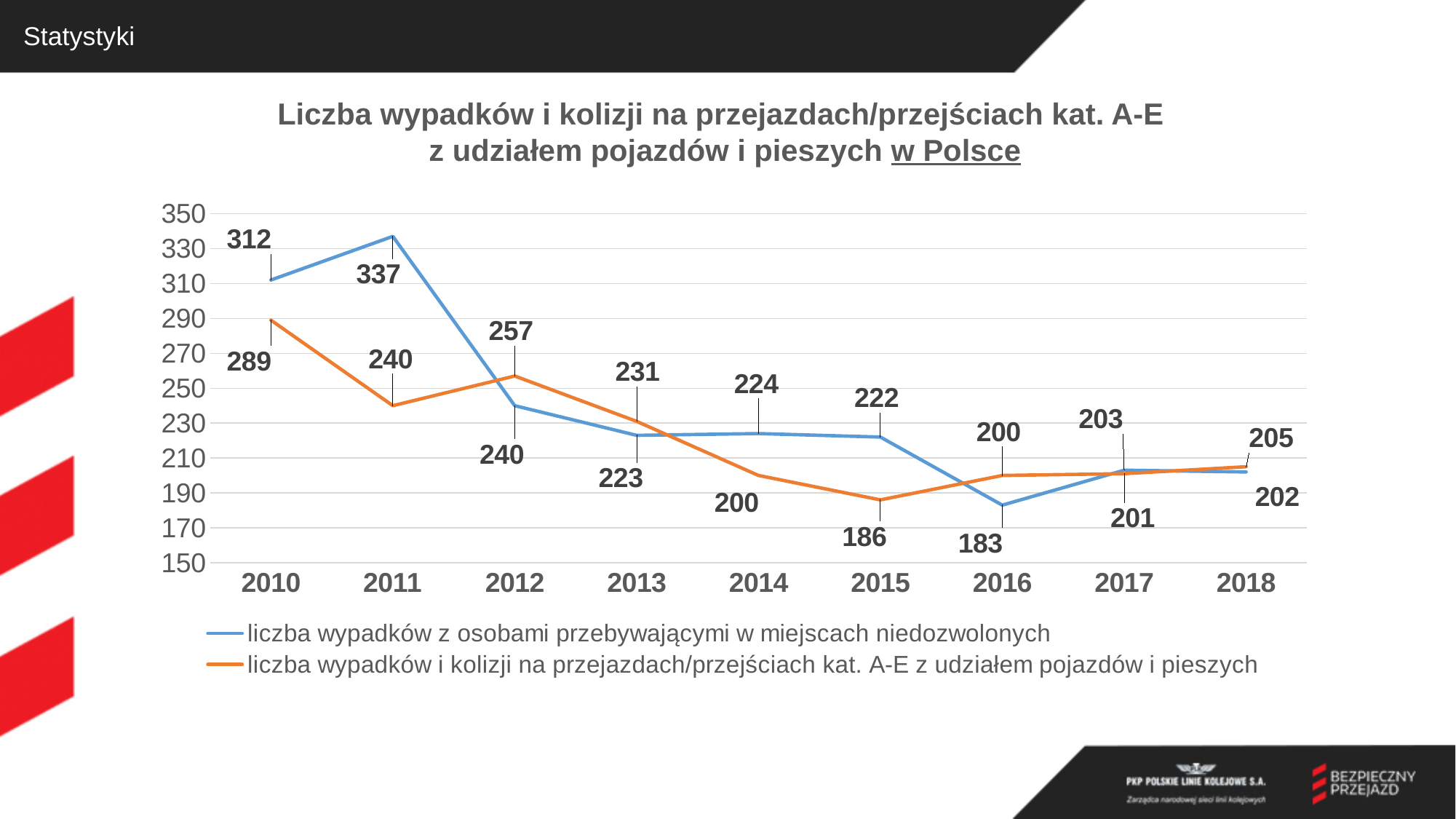
What type of chart is shown on the slide? line chart In 2012, which series has the larger value, the blue or the orange? orange What is the value of the orange series in 2018? 205 What is the difference between the blue series value in 2010 and the orange series value in 2010? 23 What is the value of the blue series in 2016? 183 What is the value of the orange series (liczba wypadków i kolizji na przejazdach/przejściach kat. A-E) in 2015? 186 What is the value of the blue series (liczba wypadków z osobami przebywającymi w miejscach niedozwolonych) in 2011? 337 How many years are shown on the x axis? 9 In which year does the blue series reach its highest value? 2011 Does the blue series generally rise or fall from 2010 to 2018? fall How many series does the legend list? 2 In which year does the orange series reach its lowest value? 2015